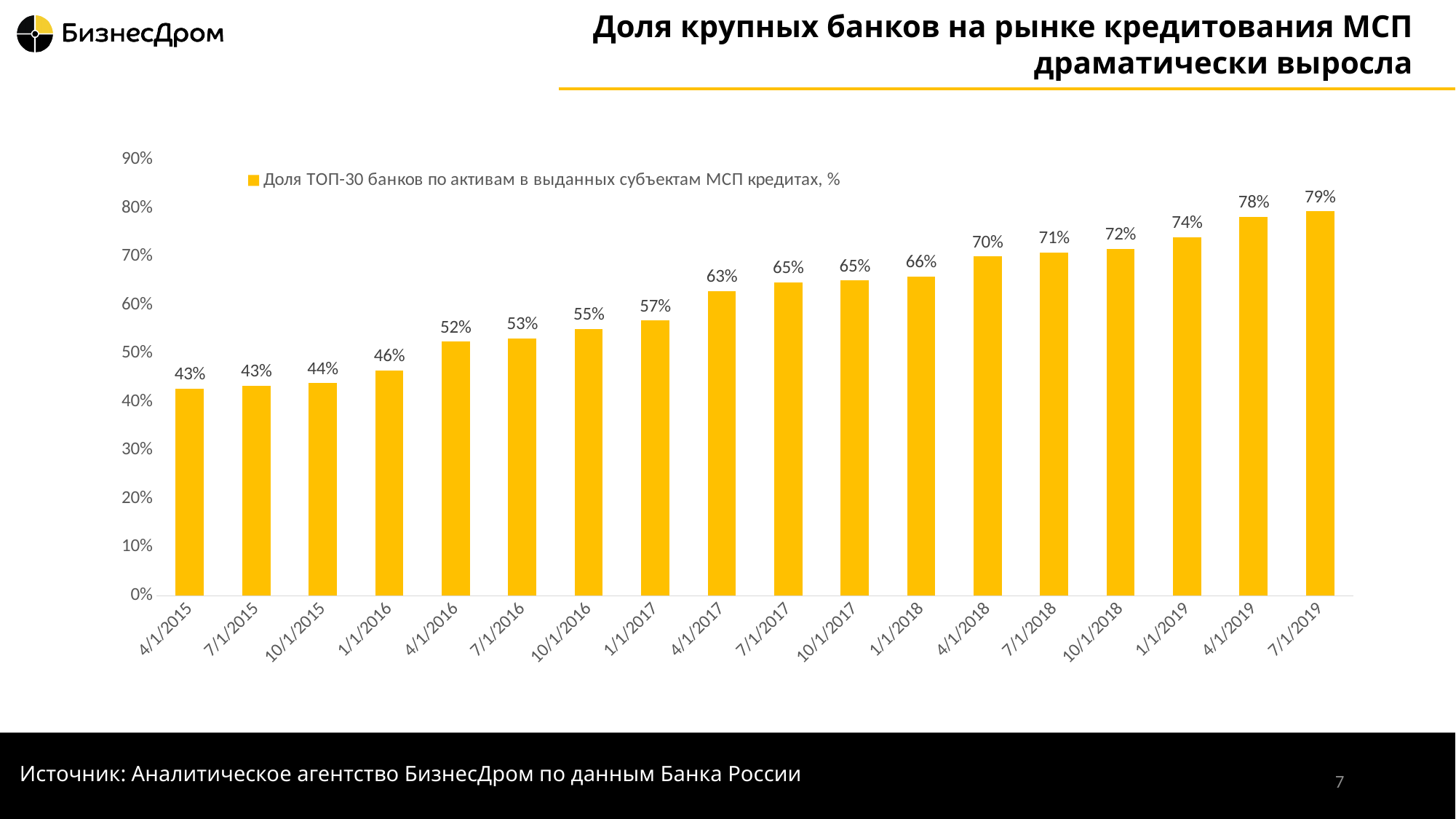
What is the legend entry for the series? Доля ТОП-30 банков по активам в выданных субъектам МСП кредитах, % What is the difference between the values for 7/1/2019 and 4/1/2015? 36% What is the value for 7/1/2019? 79% What is the value for 1/1/2017? 57% Do the values rise or fall from 4/1/2015 to 7/1/2019? rise What kind of chart is shown? bar chart Which date has the highest value? 7/1/2019 How many series does the legend list? 1 Is the value for 10/1/2016 greater or less than 50%? greater How many dates are shown on the x axis? 18 What is the value for 4/1/2015? 43% Which is larger, the value for 4/1/2017 or the value for 1/1/2018? 1/1/2018